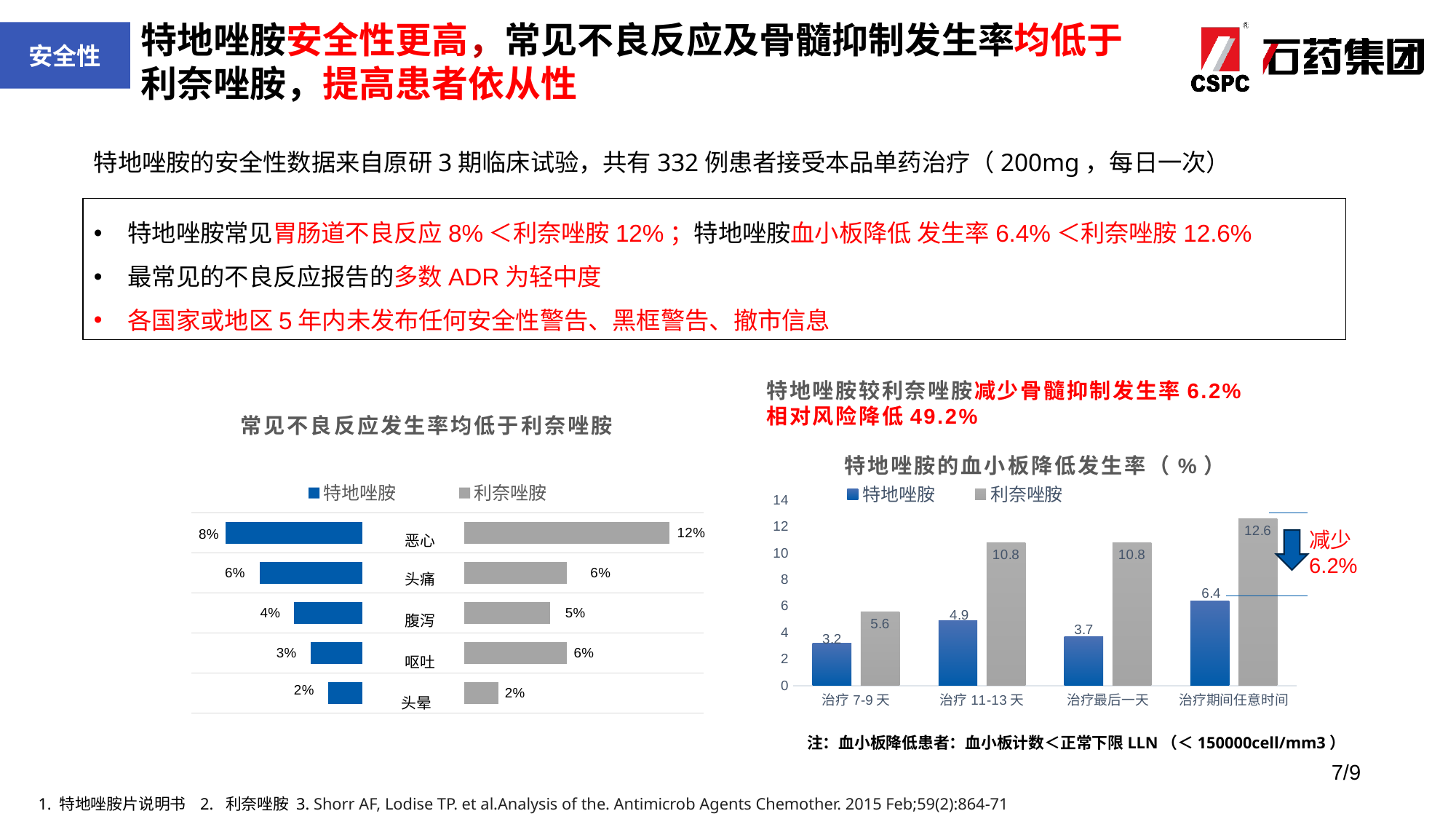
In the chart titled 常见不良反应发生率均低于利奈唑胺, what is the value for 利奈唑胺 for 呕吐? 6% In the chart titled 常见不良反应发生率均低于利奈唑胺, how many adverse reaction categories are shown? 5 In the chart titled 特地唑胺的血小板降低发生率（%）, how many series does the legend list? 2 In the chart titled 常见不良反应发生率均低于利奈唑胺, which category has the highest value for 利奈唑胺? 恶心 In the chart titled 常见不良反应发生率均低于利奈唑胺, what is the value for 特地唑胺 for 恶心? 8% In the chart titled 特地唑胺的血小板降低发生率（%）, which is larger for 治疗最后一天: 特地唑胺 or 利奈唑胺? 利奈唑胺 In the chart titled 特地唑胺的血小板降低发生率（%）, what is the value for 特地唑胺 for 治疗 11-13 天? 4.9 In the chart titled 特地唑胺的血小板降低发生率（%）, what is the difference between 利奈唑胺 and 特地唑胺 for 治疗期间任意时间? 6.2 In the chart titled 常见不良反应发生率均低于利奈唑胺, what is the difference between 利奈唑胺 and 特地唑胺 for 恶心? 4% What kind of chart is the chart titled 特地唑胺的血小板降低发生率（%）? bar chart In the chart titled 常见不良反应发生率均低于利奈唑胺, which category has the lowest value for 特地唑胺? 头晕 In the chart titled 特地唑胺的血小板降低发生率（%）, what is the value for 利奈唑胺 for 治疗期间任意时间? 12.6